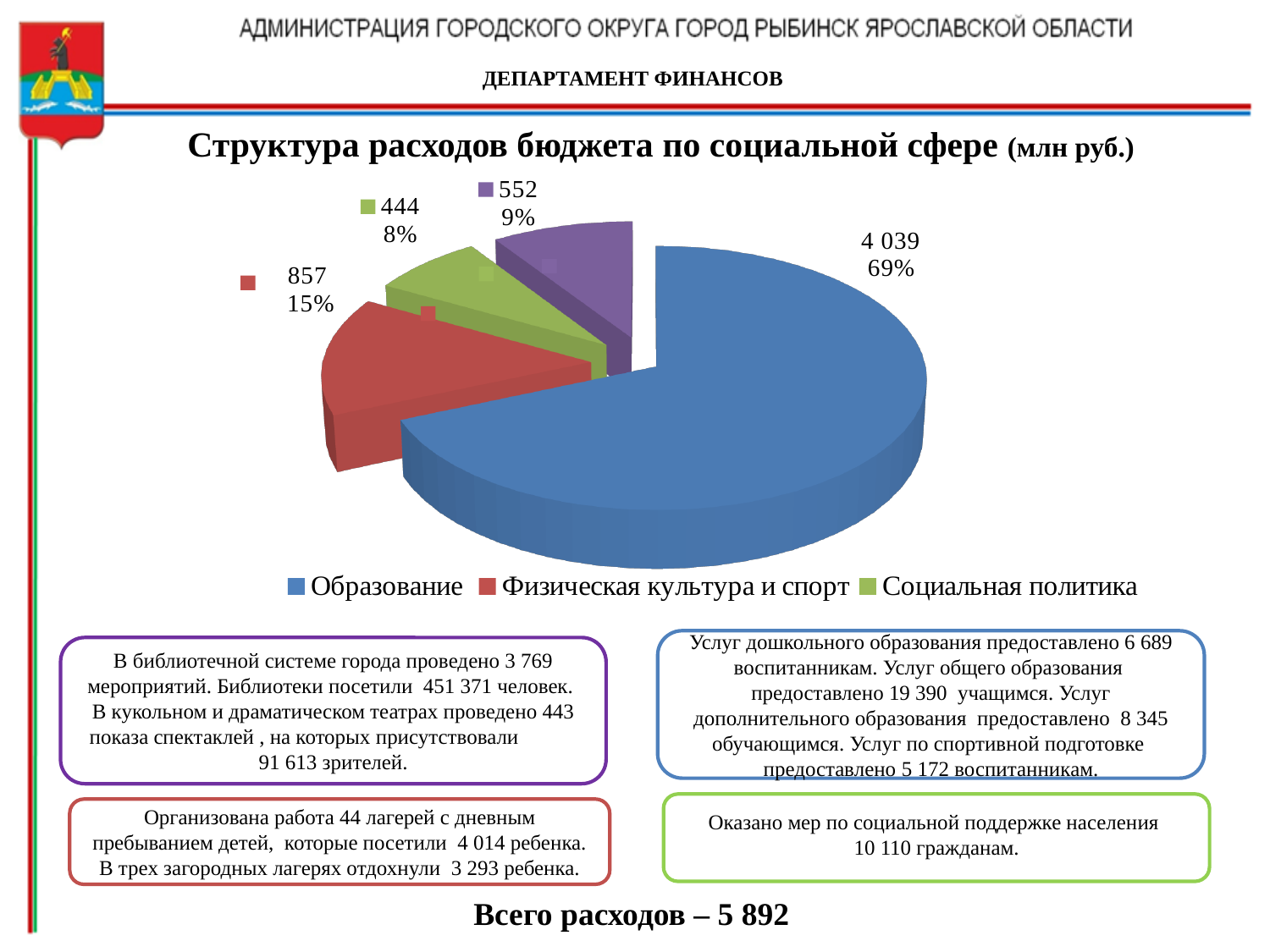
What is the difference between the Образование slice (4 039) and the slice valued 857? 3 182 What type of chart is shown on the slide? pie chart Which slice is larger, the purple one or the green one? the purple one What is the value of the smallest slice in the pie chart? 444 Which category has the largest slice in the pie chart? Образование What value is shown for the slice labelled 9%? 552 What value is shown for the slice labelled 15%? 857 What share of the pie does Образование account for? 69% How many slices does the pie chart have? 4 In what units are the values in the chart title given? млн руб. How many entries does the chart legend list? 3 What is the value shown for Образование in the pie chart? 4 039